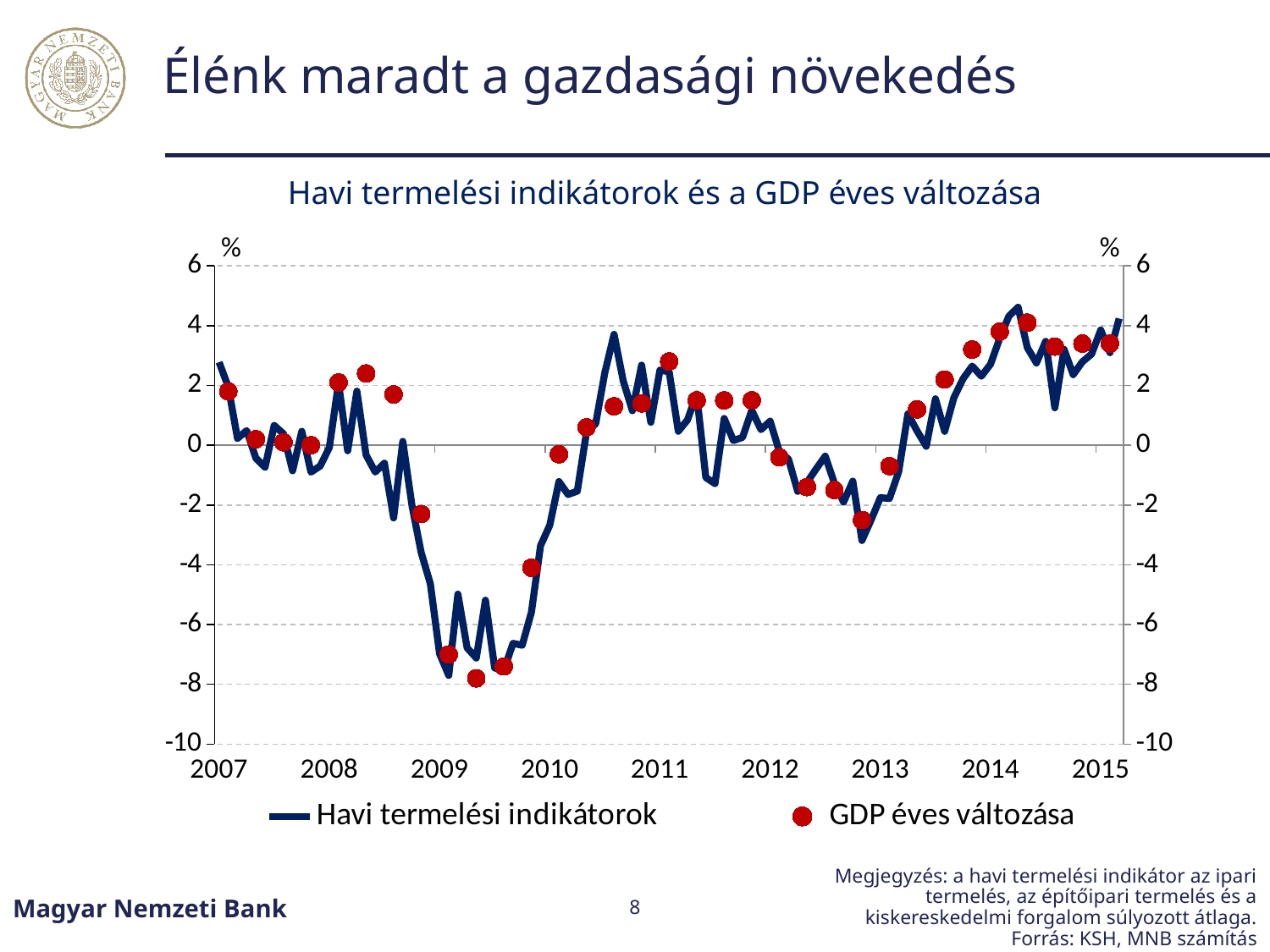
What kind of chart is shown on the slide? line chart Is the peak of the Havi termelési indikátorok line in 2010 greater or less than 2? greater What is the title of the chart? Havi termelési indikátorok és a GDP éves változása Is the lowest GDP éves változása value in 2009 greater or less than -6? less How many series does the legend list? 2 Is the peak of the Havi termelési indikátorok line in 2014 greater or less than 4? greater In which year does the GDP éves változása series reach its lowest value? 2009 How many years are labelled on the x axis? 9 Does the Havi termelési indikátorok line rise or fall between 2013 and 2014? rise In which year does the Havi termelési indikátorok line reach its lowest point? 2009 What are the two series named in the legend? Havi termelési indikátorok; GDP éves változása